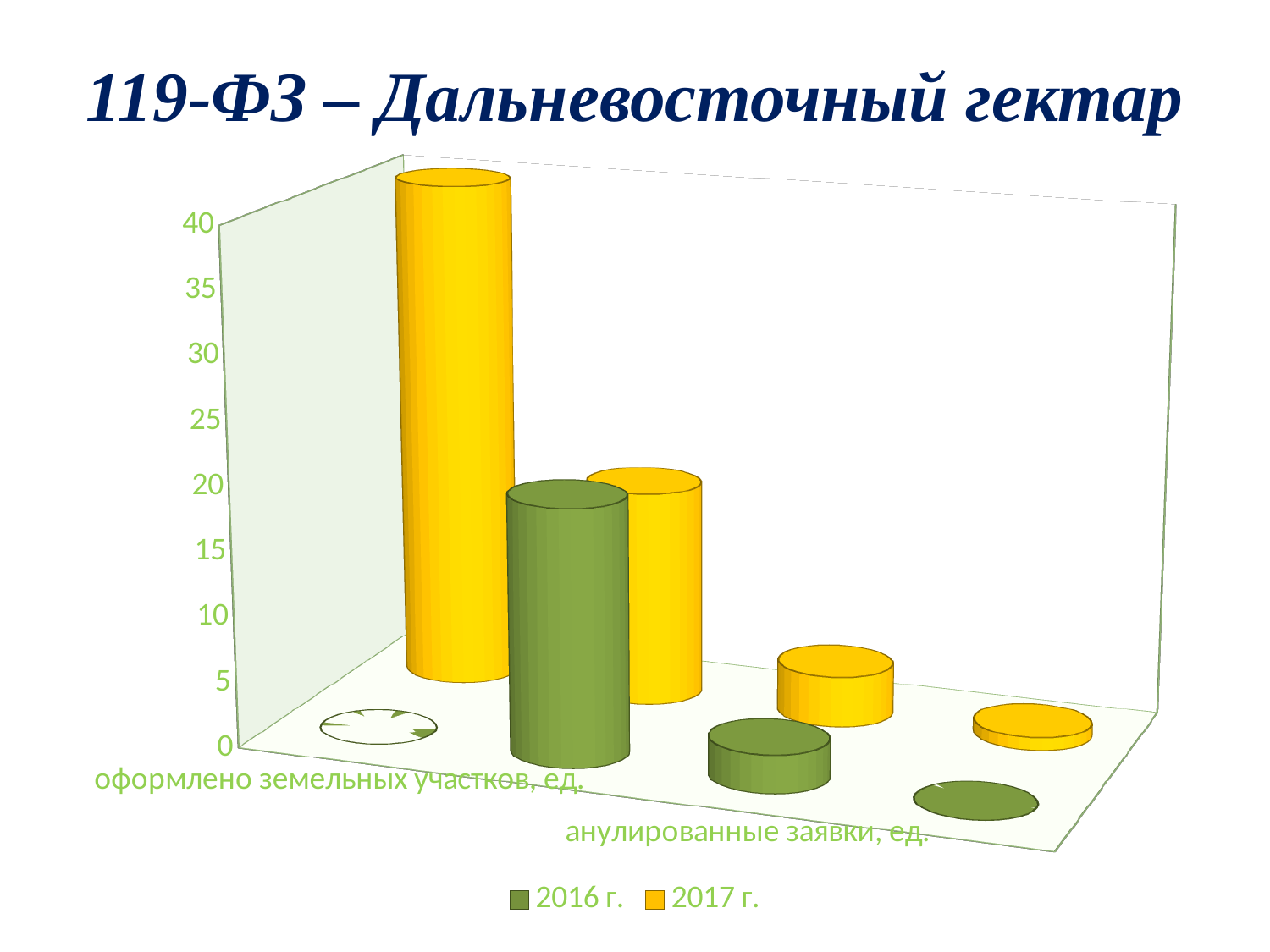
Is the 2017 г. value for 'оформлено земельных участков, ед.' greater or less than 30? greater How many series does the legend list? 2 Which category has the highest 2017 г. value? оформлено земельных участков, ед. How many groups of bars are plotted on the chart? 4 Which series contains the tallest bar on the chart? 2017 г. What is the title of the slide with the chart? 119-ФЗ – Дальневосточный гектар For 'оформлено земельных участков, ед.', which series has the larger value, 2016 г. or 2017 г.? 2017 г. Is the 2016 г. value for 'анулированные заявки, ед.' greater or less than 10? less What are the two series named in the legend? 2016 г. and 2017 г. What kind of chart is shown on the slide? bar chart Is the 2016 г. value for 'оформлено земельных участков, ед.' greater or less than 5? less